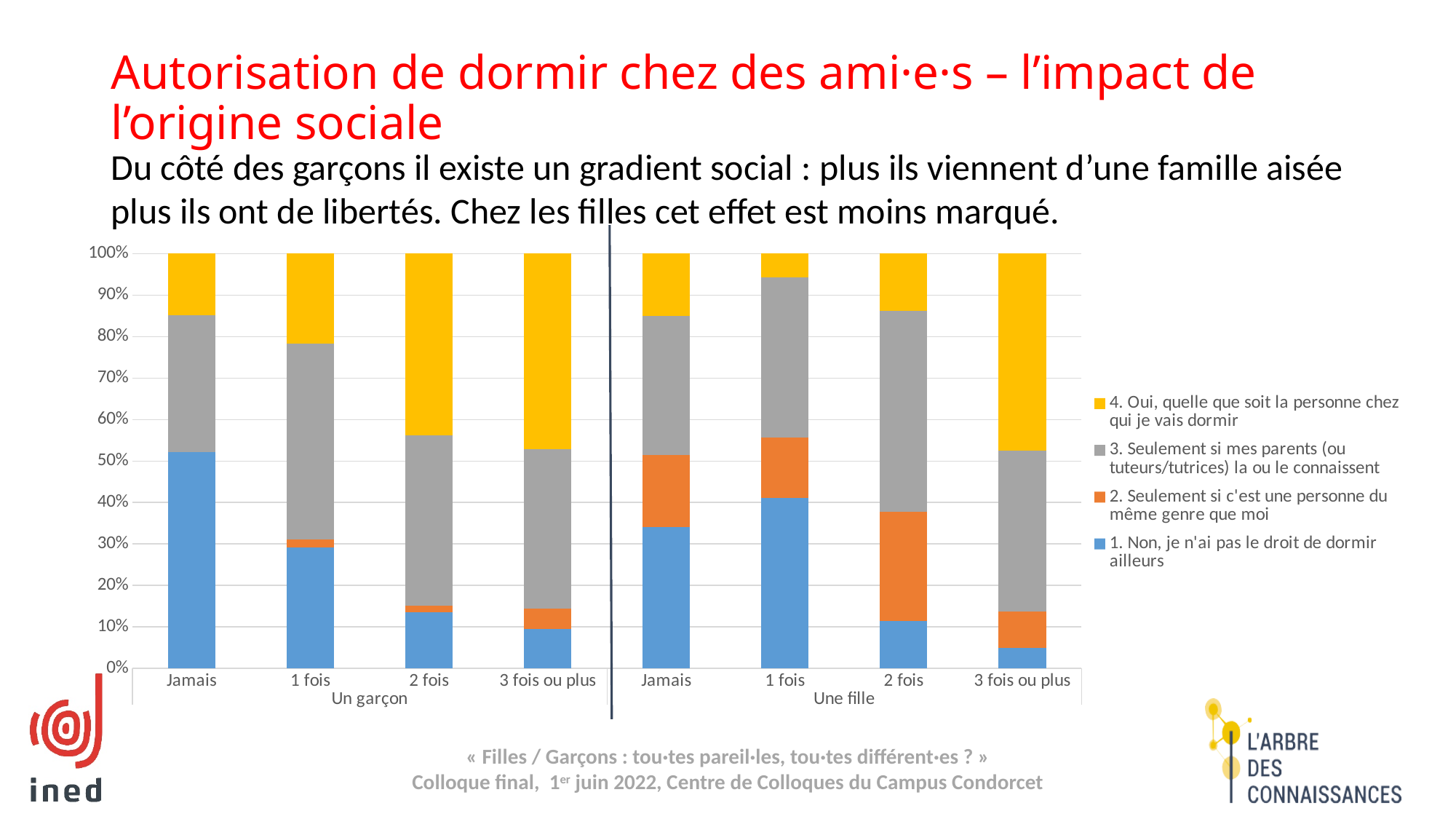
How many series does the legend list? 4 Is the blue segment (1. Non, je n'ai pas le droit de dormir ailleurs) for '3 fois ou plus' in the 'Une fille' group greater or less than 10%? less Is the blue segment (1. Non, je n'ai pas le droit de dormir ailleurs) for '1 fois' in the 'Une fille' group greater or less than 30%? greater Which is larger: the orange segment (2. Seulement si c'est une personne du même genre que moi) for '2 fois' in the 'Un garçon' group or for '2 fois' in the 'Une fille' group? Une fille, 2 fois Which bar has the largest blue segment (1. Non, je n'ai pas le droit de dormir ailleurs)? Un garçon, Jamais How many stacked bars are plotted in the chart? 8 Is the blue segment (1. Non, je n'ai pas le droit de dormir ailleurs) for 'Jamais' in the 'Un garçon' group greater or less than 50%? greater What is the total of each stacked bar in the chart? 100% Within the 'Un garçon' group, does the blue segment (1. Non, je n'ai pas le droit de dormir ailleurs) rise or fall from 'Jamais' to '3 fois ou plus'? fall Which is larger: the blue segment for 'Jamais' in the 'Un garçon' group or the blue segment for 'Jamais' in the 'Une fille' group? Un garçon, Jamais Which colour represents the series '4. Oui, quelle que soit la personne chez qui je vais dormir'? Yellow What kind of chart is shown on the slide? Stacked bar chart